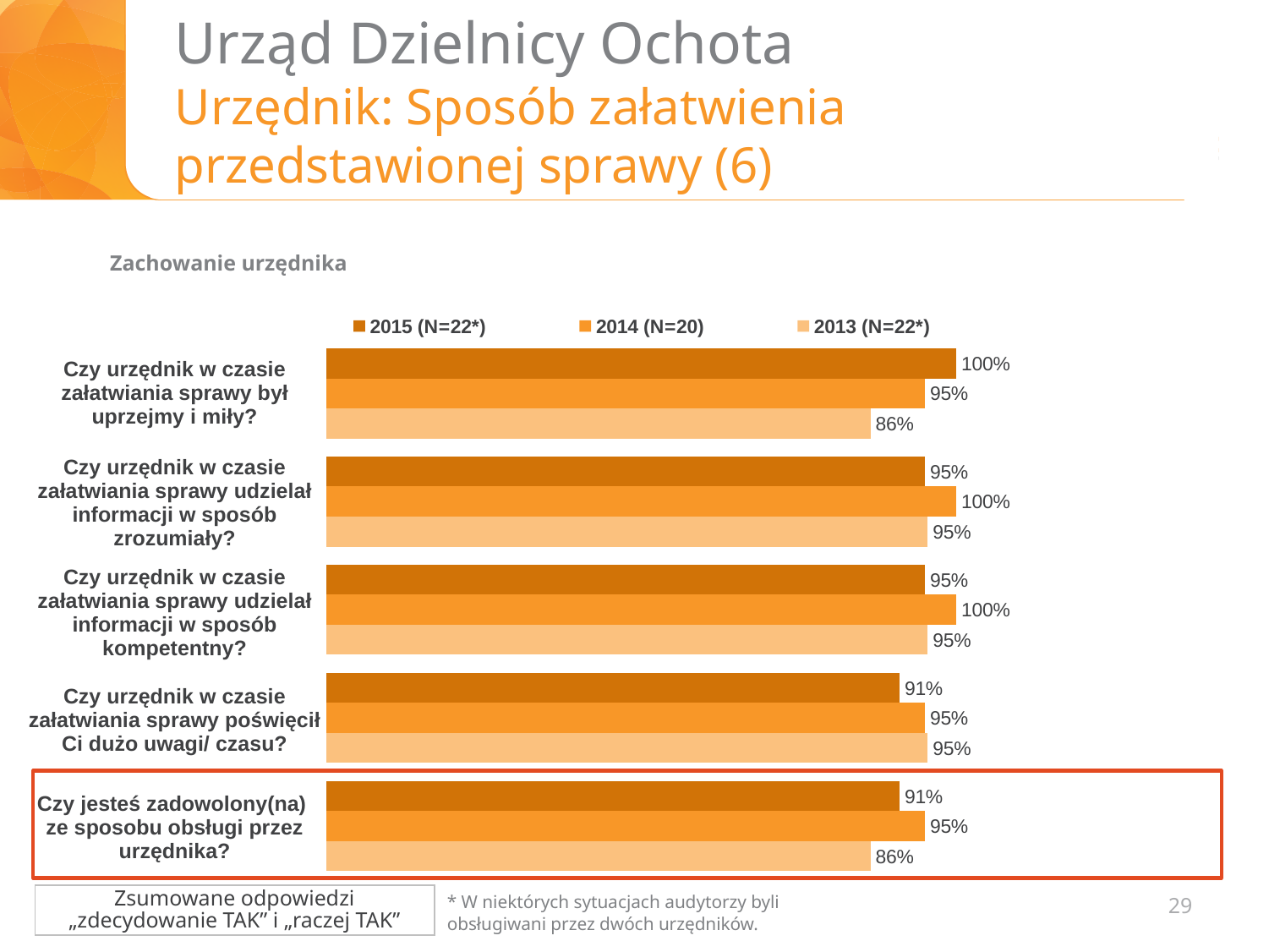
What is the 2015 value for "Czy urzędnik w czasie załatwiania sprawy był uprzejmy i miły?"? 100% What is the 2013 value for "Czy jesteś zadowolony(na) ze sposobu obsługi przez urzędnika?"? 86% What is the 2015 value for "Czy urzędnik w czasie załatwiania sprawy poświęcił Ci dużo uwagi/ czasu?"? 91% What is the sample size (N) for the 2014 series according to the legend? 20 How many question categories are shown in the chart? 5 What type of chart is shown on the slide? Bar chart What is the subtitle shown above the chart? Zachowanie urzędnika What is the difference between the 2015 and 2013 values for "Czy urzędnik w czasie załatwiania sprawy był uprzejmy i miły?"? 14 percentage points What is the 2014 value for "Czy urzędnik w czasie załatwiania sprawy udzielał informacji w sposób kompetentny?"? 100% For "Czy jesteś zadowolony(na) ze sposobu obsługi przez urzędnika?", which year has the higher value: 2014 or 2015? 2014 How many series does the legend list? 3 Which category has the lowest 2015 value? Czy urzędnik w czasie załatwiania sprawy poświęcił Ci dużo uwagi/ czasu? and Czy jesteś zadowolony(na) ze sposobu obsługi przez urzędnika? (both 91%)